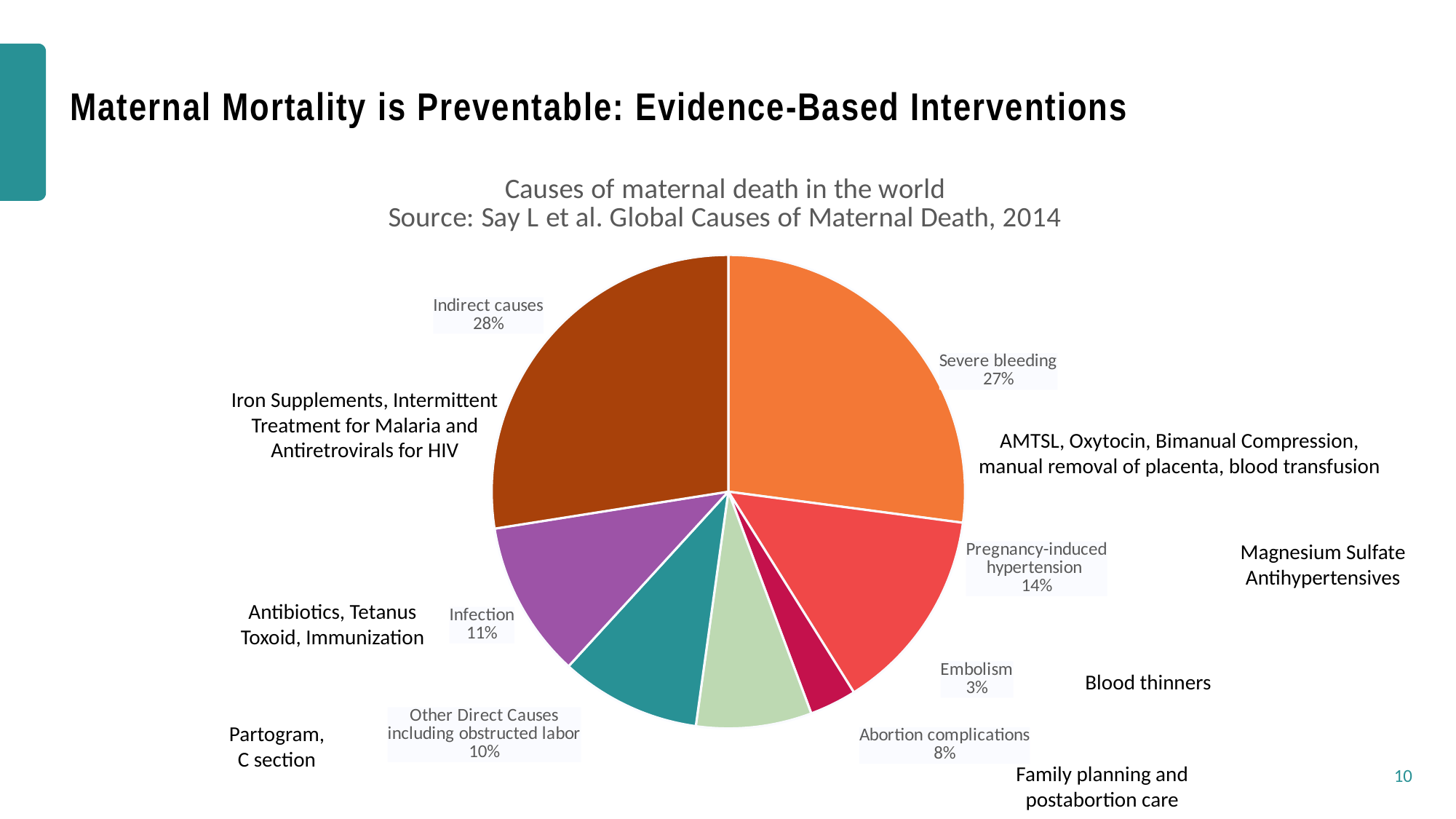
Which is larger, Infection or Other Direct Causes including obstructed labor? Infection What share of maternal deaths is attributed to Severe bleeding? 27% How many slices does the pie chart have? 7 What is the title of the chart? Causes of maternal death in the world What is the value shown for Embolism? 3% What is the combined share of Embolism and Abortion complications? 11% Which cause has the smallest slice of the pie? Embolism What kind of chart is shown on the slide? Pie chart Which cause has the largest slice of the pie? Indirect causes What is the difference in percentage points between Severe bleeding and Infection? 16 What percentage is shown for Abortion complications? 8% What percentage of the pie is Pregnancy-induced hypertension? 14%